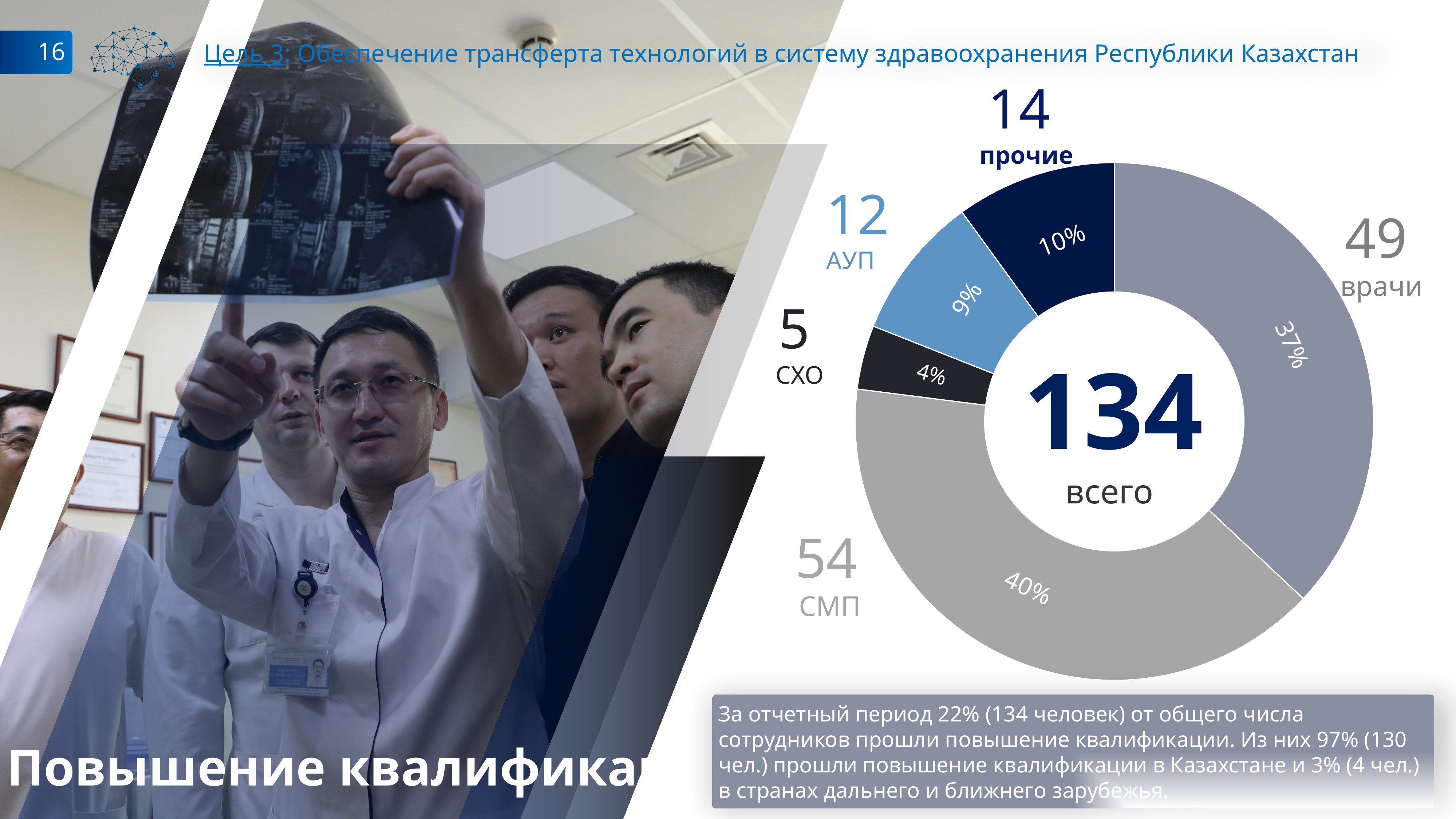
What is the value for АУП? 12 What share of the donut does врачи represent? 37% What is the difference between the values for СМП and врачи? 5 What kind of chart is shown on the slide? Donut (pie) chart What is the value for СХО? 5 Which category has the highest value? СМП What is the value for врачи? 49 How many categories does the donut chart show? 5 What total is shown in the centre of the donut chart? 134 What share of the donut does прочие represent? 10% Which category has the lowest value? СХО What is the value for СМП? 54